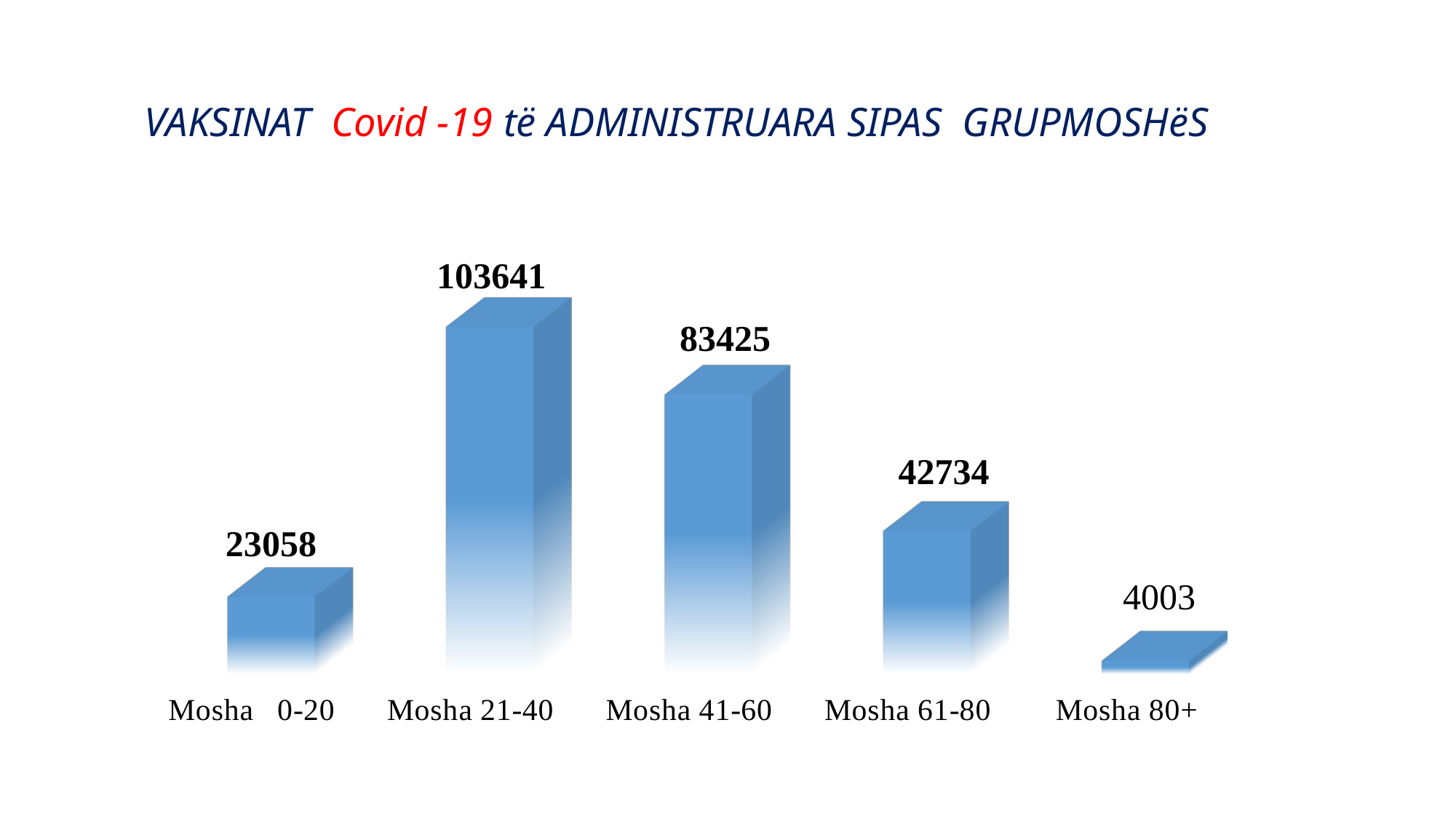
What is the value for Mosha 61-80? 42734 What kind of chart is shown on the slide? bar chart What is the value for Mosha 0-20? 23058 How many age groups are shown in the chart? 5 Which age group has the highest value? Mosha 21-40 What is the value for Mosha 80+? 4003 Which age group has the lowest value? Mosha 80+ Which is larger, the value for Mosha 41-60 or the value for Mosha 61-80? Mosha 41-60 What is the difference between the values for Mosha 61-80 and Mosha 0-20? 19676 What is the total of all the values shown in the chart? 256861 What is the value for Mosha 21-40? 103641 What is the difference between the values for Mosha 21-40 and Mosha 41-60? 20216